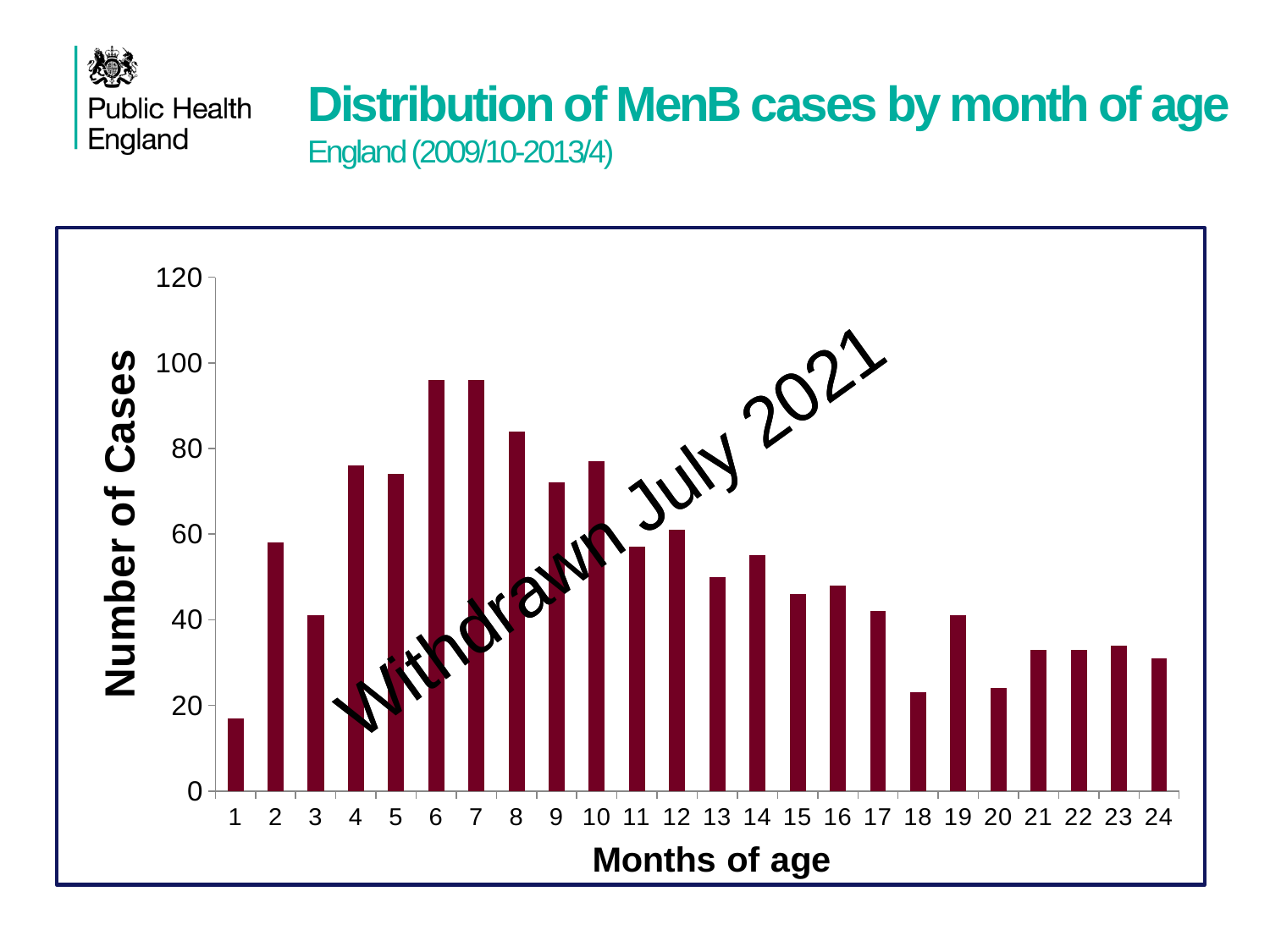
What kind of chart is shown on the slide? bar chart How many months of age are plotted on the x axis? 24 Is the number of cases at 6 months of age greater or less than 100? less Do the number of cases generally rise or fall from 7 months of age to 24 months of age? fall What is the label on the vertical axis of the chart? Number of Cases Is the number of cases at 8 months of age greater or less than 80? greater Is the number of cases at 1 month of age greater or less than 20? less Which has more cases, 2 months of age or 3 months of age? 2 months of age Which month of age has the lowest number of cases? 1 Which has more cases, 18 months of age or 19 months of age? 19 months of age